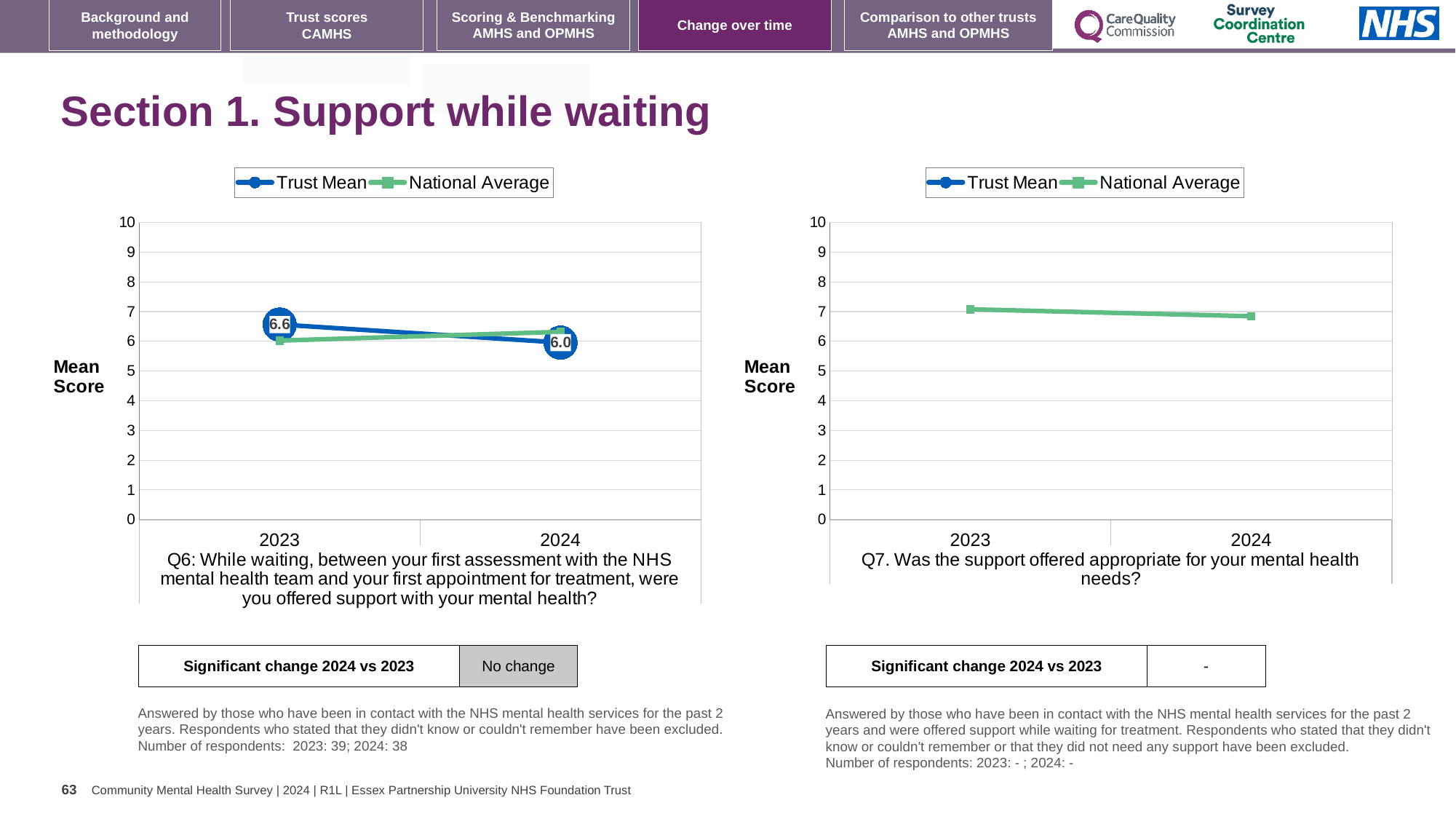
How many years are shown on the x axis of the Q6 chart on the left? 2 In the Q6 chart on the left, which is higher in 2023, the Trust Mean or the National Average? Trust Mean In the Q7 chart on the right, is the National Average for 2024 greater or less than 6? greater In the Q6 chart on the left, does the Trust Mean rise or fall from 2023 to 2024? fall In the Q6 chart on the left, which year has the higher Trust Mean score? 2023 In the Q6 chart on the left, what is the Trust Mean score for 2024? 6.0 What type of chart is used on this slide? Line chart In the Q6 chart on the left, is the National Average for 2024 greater or less than 7? less In the Q6 chart on the left, by how much did the Trust Mean score change between 2023 and 2024? 0.6 What is the label on the y axis of the Q6 chart on the left? Mean Score In the Q6 chart on the left, what is the Trust Mean score for 2023? 6.6 How many series does the legend of the Q7 chart on the right list? 2